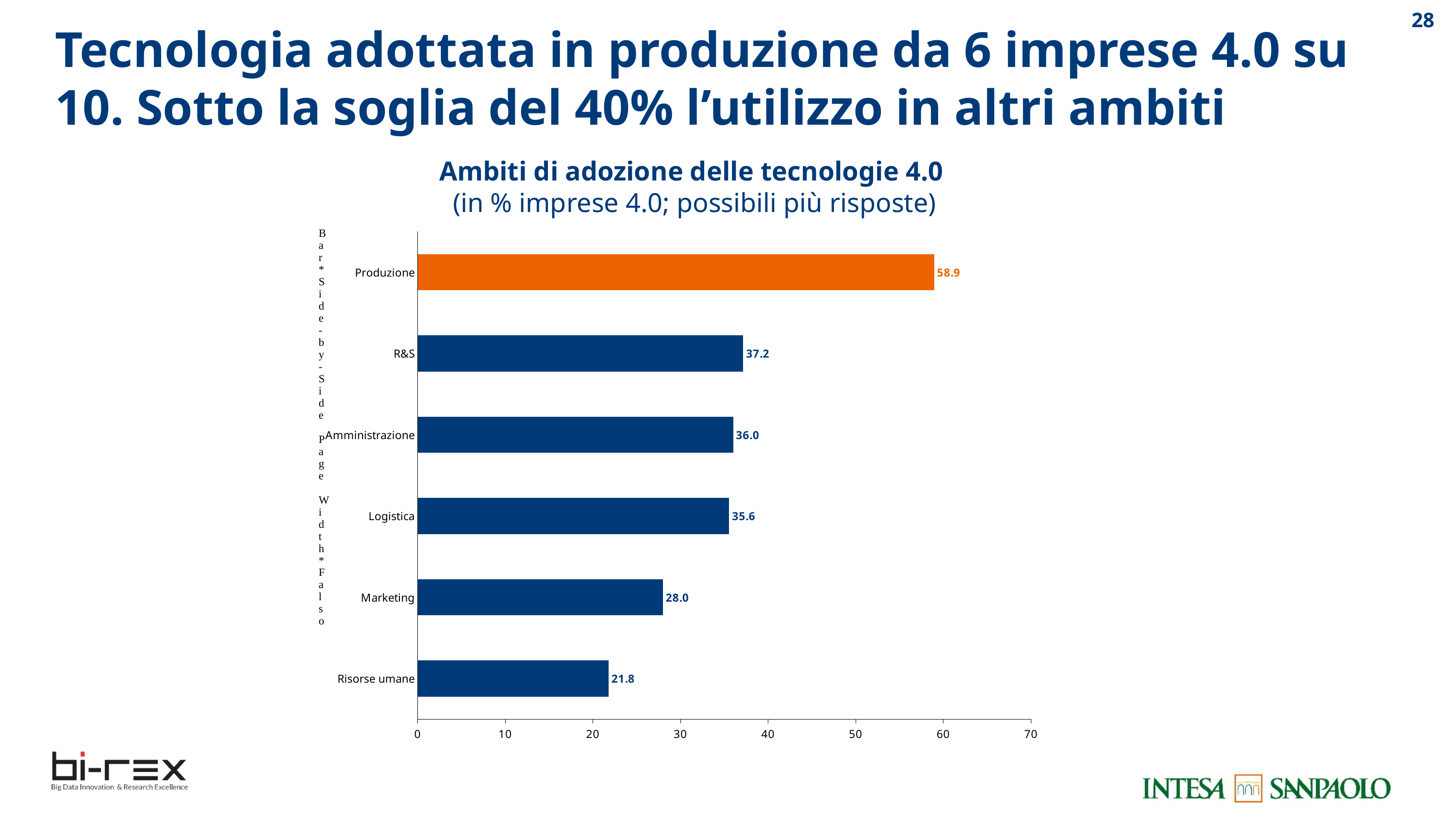
Is the value for Amministrazione greater or less than 40? less Which category has the highest value? Produzione What is the value for Risorse umane? 21.8 What is the value for Produzione? 58.9 Which is larger, the value for Marketing or the value for Logistica? Logistica What is the difference between the values for Marketing and Risorse umane? 6.2 Which category has the lowest value? Risorse umane What kind of chart is shown on the slide? bar chart How many categories are shown in the chart? 6 What is the value for Logistica? 35.6 What is the difference between the values for Produzione and R&S? 21.7 Which bar is coloured orange rather than blue? Produzione